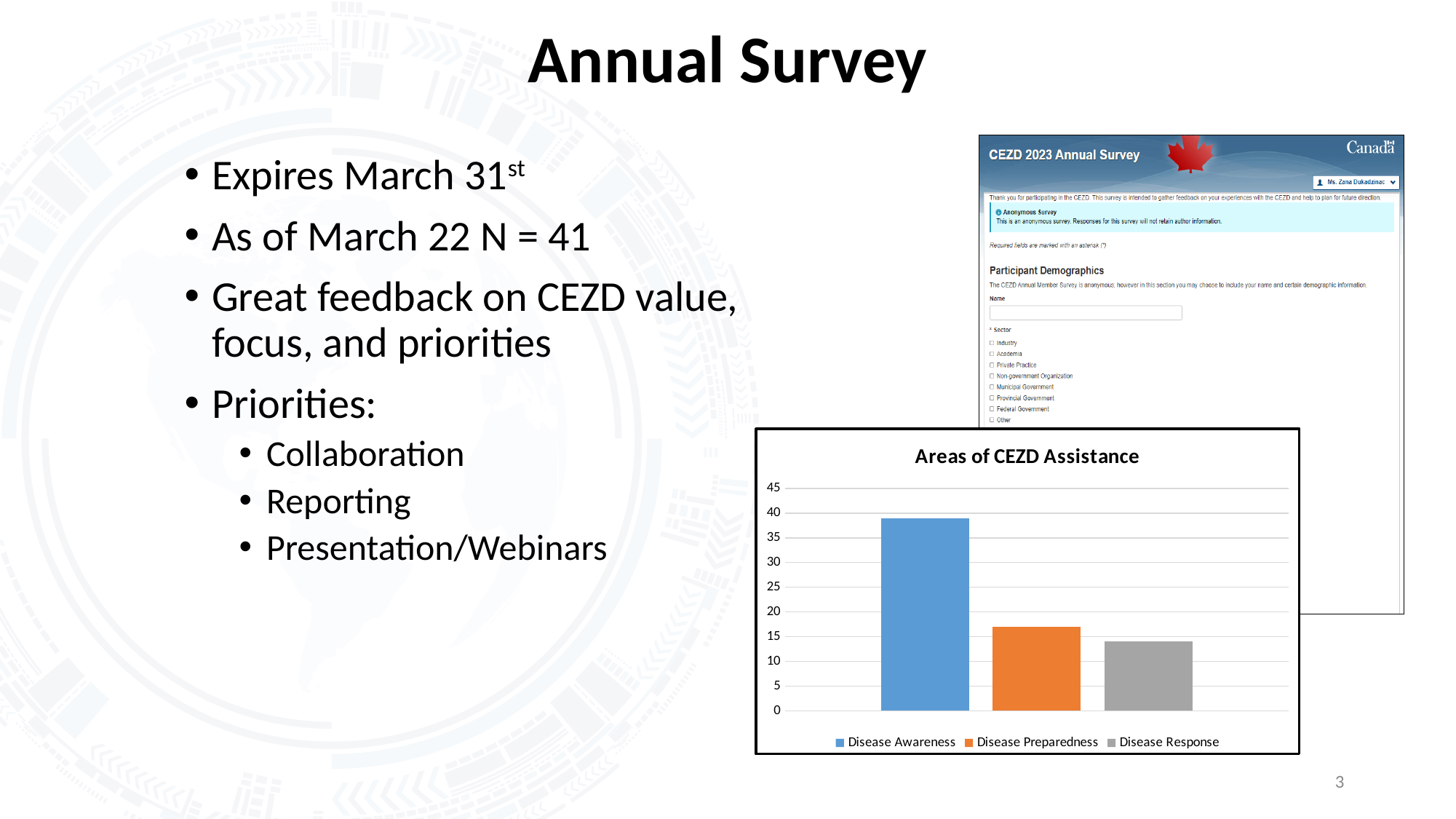
Is the value for Disease Awareness greater or less than 35? greater Which is larger in the Areas of CEZD Assistance chart, Disease Preparedness or Disease Response? Disease Preparedness Which category has the lowest value in the Areas of CEZD Assistance chart? Disease Response How many bars are plotted in the Areas of CEZD Assistance chart? 3 Is the value for Disease Response greater or less than 10? greater How many entries does the legend of the Areas of CEZD Assistance chart list? 3 What is the title of the chart on the slide? Areas of CEZD Assistance Is the value for Disease Preparedness greater or less than 20? less Which category has the highest value in the Areas of CEZD Assistance chart? Disease Awareness What kind of chart is shown on the slide? bar chart Do the bar values rise or fall from left to right in the Areas of CEZD Assistance chart? fall What colour is the Disease Awareness bar in the Areas of CEZD Assistance chart? blue